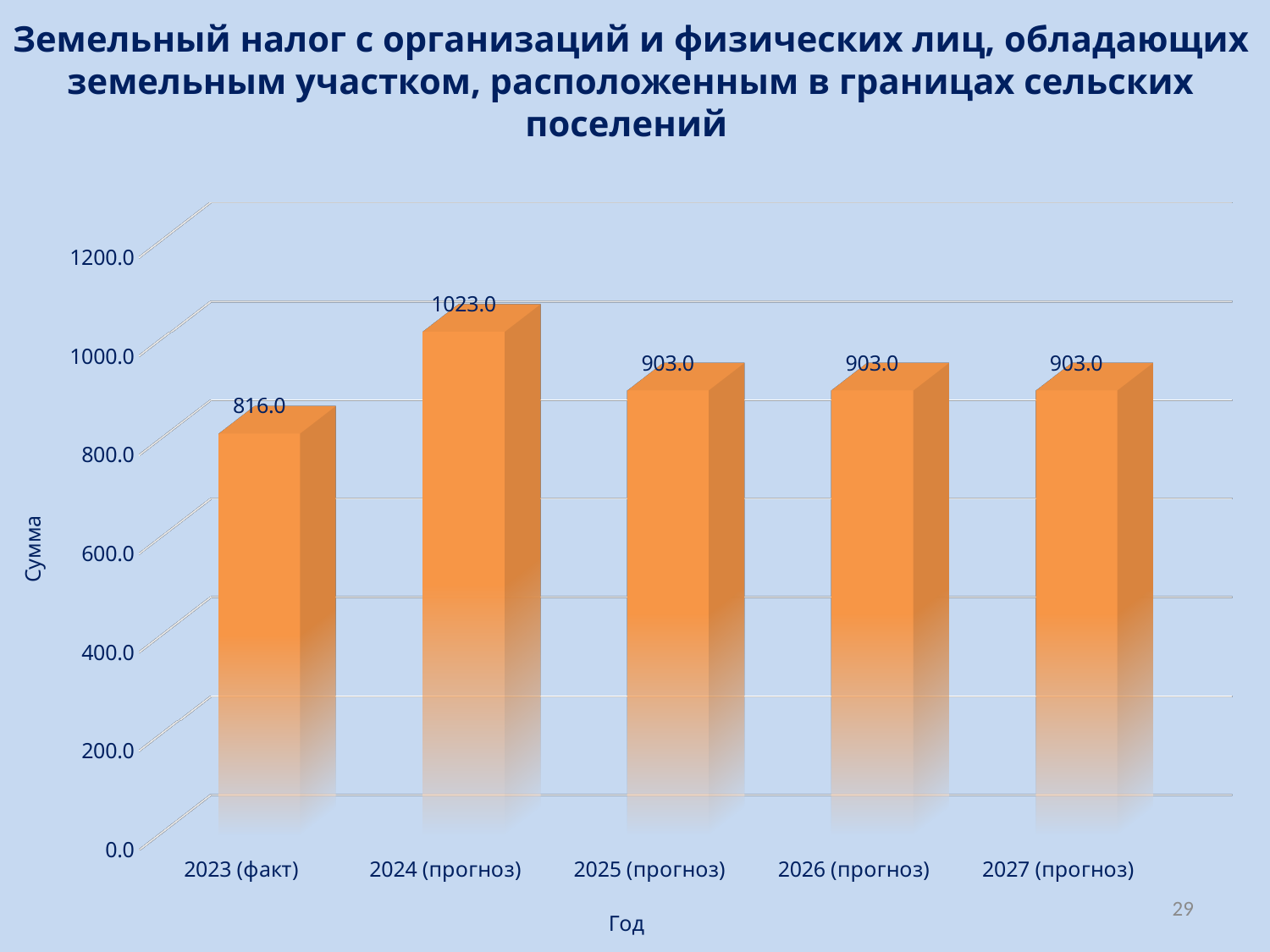
What is the label of the vertical axis? Сумма What is the difference between the values for 2024 (прогноз) and 2025 (прогноз)? 120.0 Which year has the lowest value? 2023 (факт) Is the value for 2024 (прогноз) greater or less than 1000.0? greater How many years are shown on the x axis? 5 What kind of chart is shown on the slide? bar chart What is the difference between the values for 2024 (прогноз) and 2023 (факт)? 207.0 What is the value for 2026 (прогноз)? 903.0 What is the value for 2024 (прогноз)? 1023.0 Which is larger, the value for 2023 (факт) or the value for 2025 (прогноз)? 2025 (прогноз) Which year has the highest value? 2024 (прогноз) What is the value for 2023 (факт)? 816.0